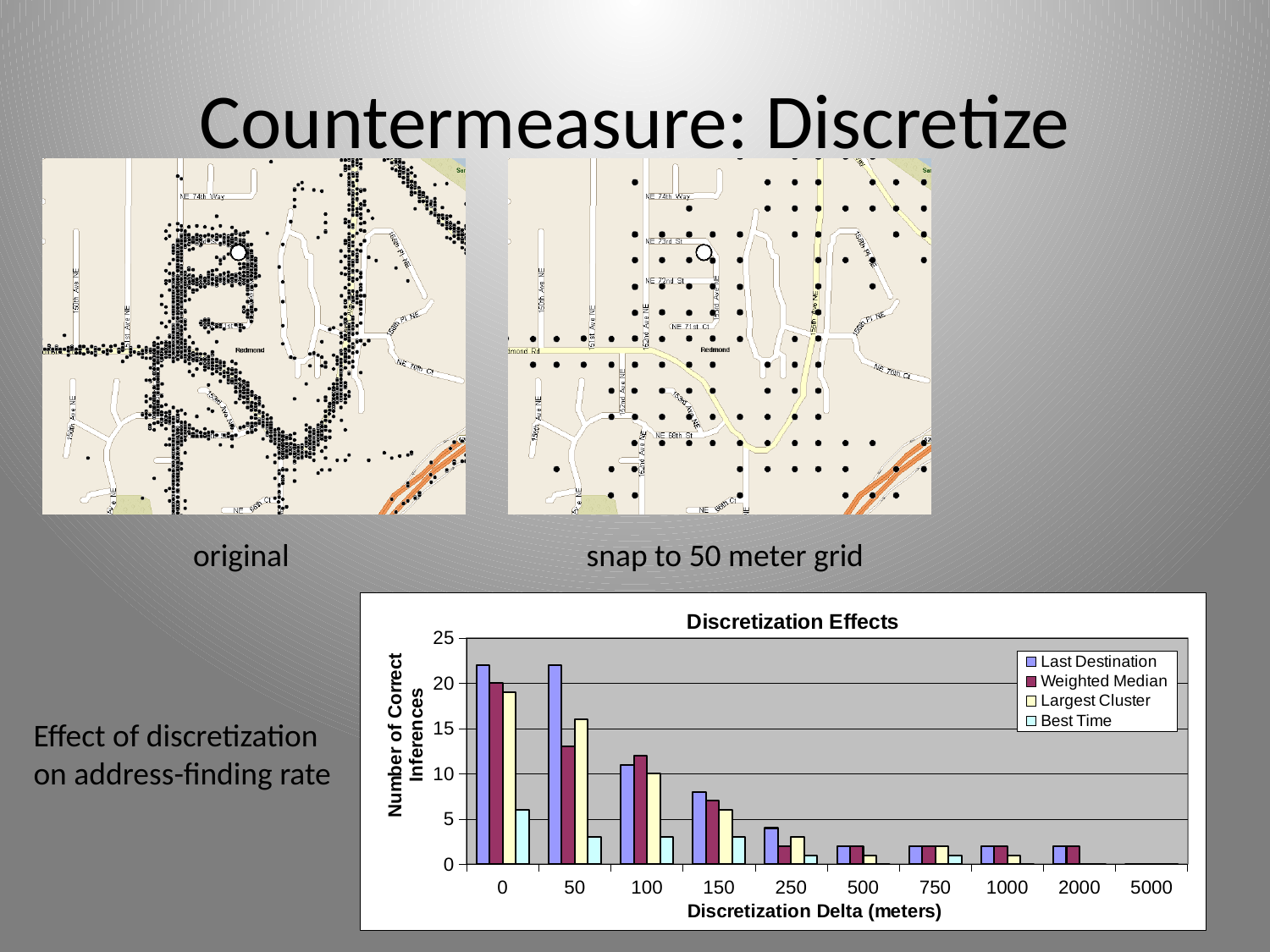
At a discretization delta of 50, which is larger: Last Destination or Weighted Median? Last Destination Is the value for Weighted Median at a discretization delta of 50 greater or less than 10? greater What is the title of the chart? Discretization Effects Do the Last Destination values generally rise or fall as the discretization delta increases? fall Is the value for Last Destination at a discretization delta of 100 greater or less than 15? less Is the value for Last Destination at a discretization delta of 0 greater or less than 20? greater How many discretization delta categories are shown on the x axis? 10 What kind of chart is shown on the slide? bar chart What is the label of the y axis? Number of Correct Inferences Which series has the lowest value at a discretization delta of 0? Best Time How many series does the chart's legend list? 4